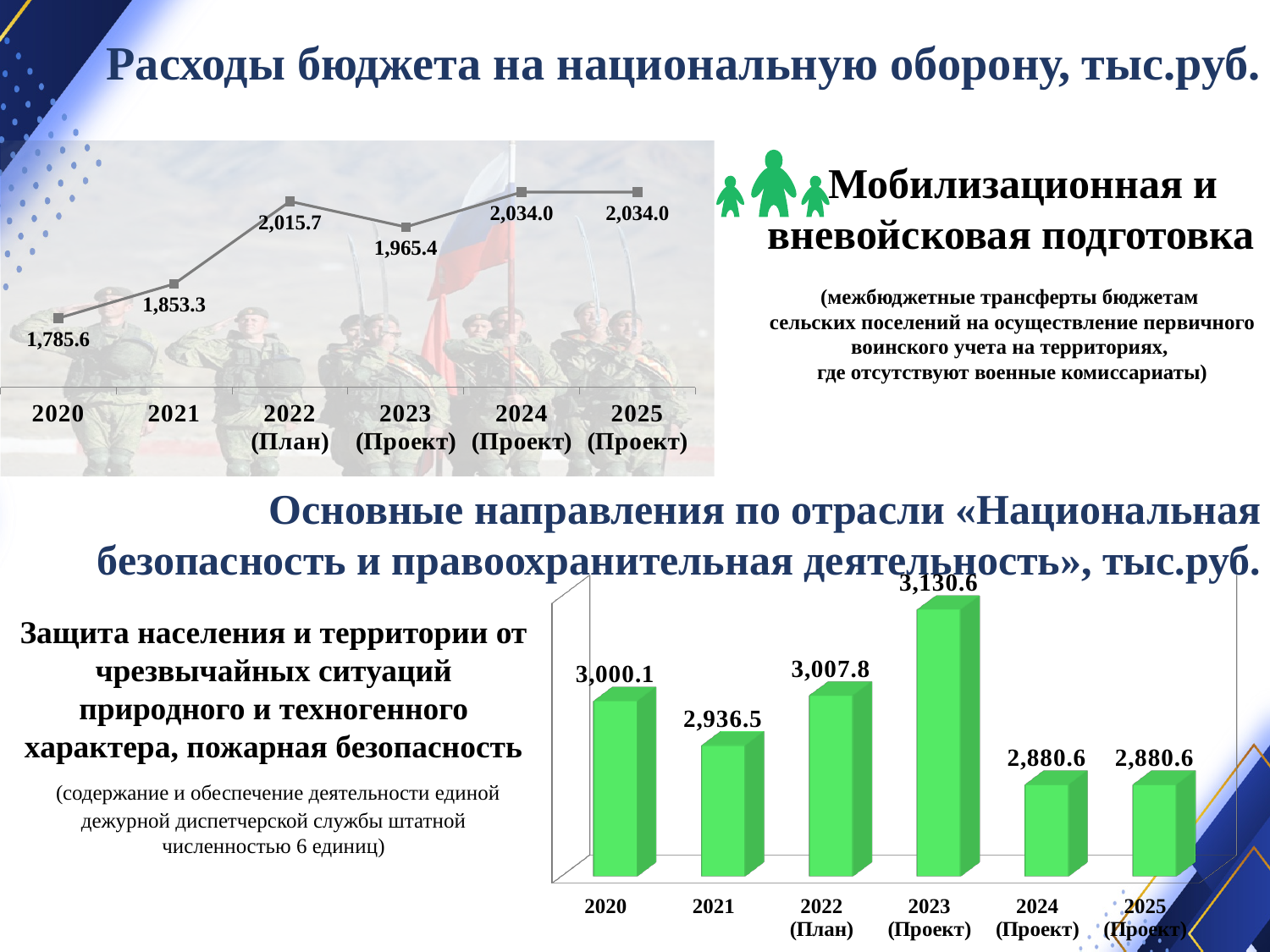
In the bottom bar chart on national security and law enforcement, which year has the highest value? 2023 (Проект) In the top line chart on national defense expenditures, how many data points are plotted? 6 In the bottom bar chart on national security and law enforcement, what is the value for 2023 (Проект)? 3,130.6 In the top line chart on national defense expenditures, what is the difference between the 2022 (План) value and the 2021 value? 162.4 In the bottom bar chart on national security and law enforcement, what is the value for 2021? 2,936.5 What type of chart is the top chart on national defense expenditures? Line chart In the bottom bar chart on national security and law enforcement, which is larger: the value for 2020 or the value for 2022 (План)? 2022 (План) In the top line chart on national defense expenditures, which year has the lowest value? 2020 What type of chart is the bottom chart on national security and law enforcement? Bar chart In the top line chart on national defense expenditures, what is the value for 2020? 1,785.6 In the bottom bar chart on national security and law enforcement, what is the difference between the 2023 (Проект) value and the 2024 (Проект) value? 250.0 In the top line chart on national defense expenditures, what is the value for 2023 (Проект)? 1,965.4